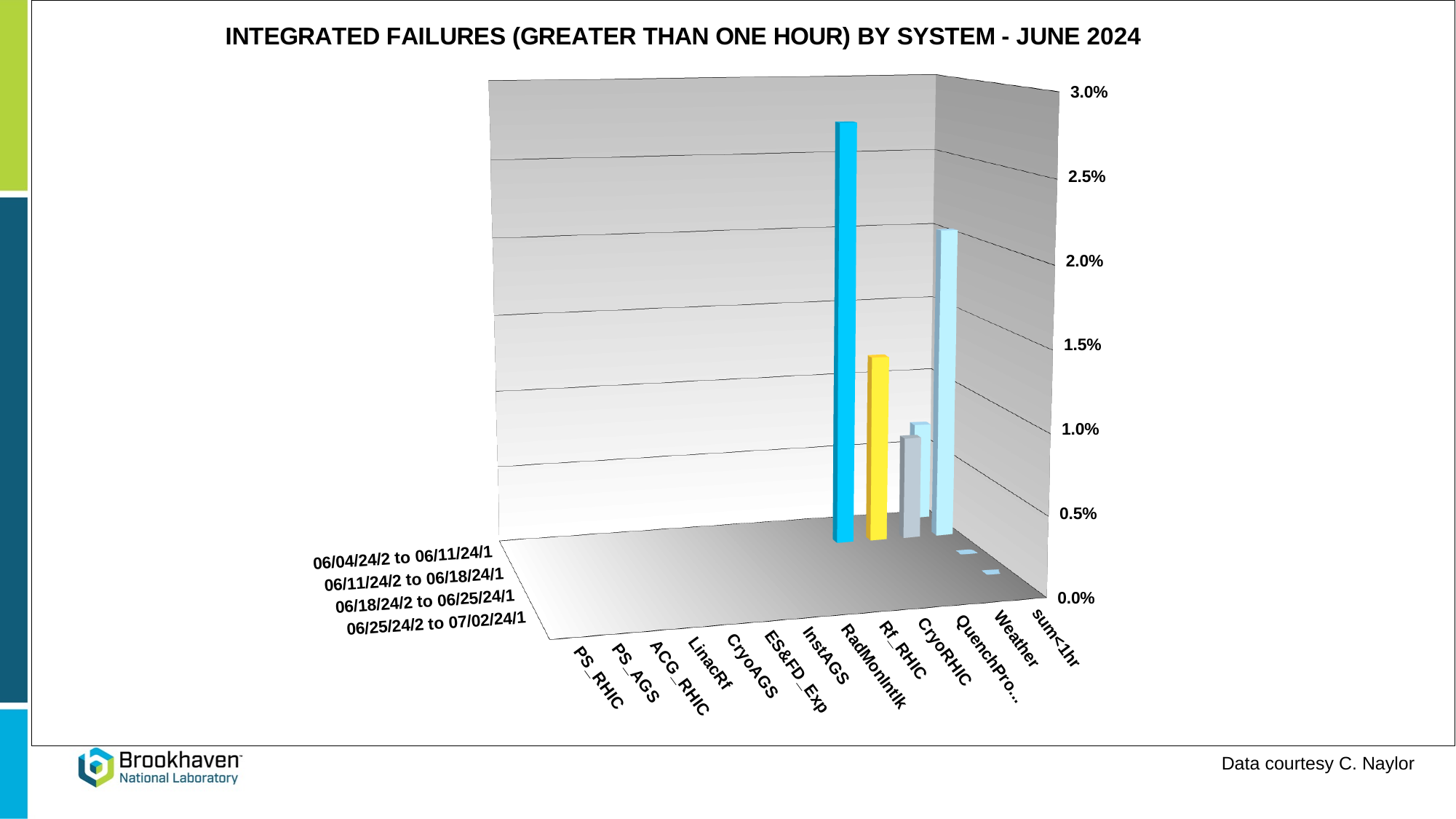
What is the highest value shown on the vertical axis of the chart? 3.0% What is the title of the chart? INTEGRATED FAILURES (GREATER THAN ONE HOUR) BY SYSTEM - JUNE 2024 Is the tallest bar in the chart greater or less than 3.0%? less How many system categories are listed along the x axis of the chart? 13 What kind of chart is shown on the slide? bar chart Is the tallest bar in the chart greater or less than 2.5%? greater How many date-range series are shown on the depth axis of the chart? 4